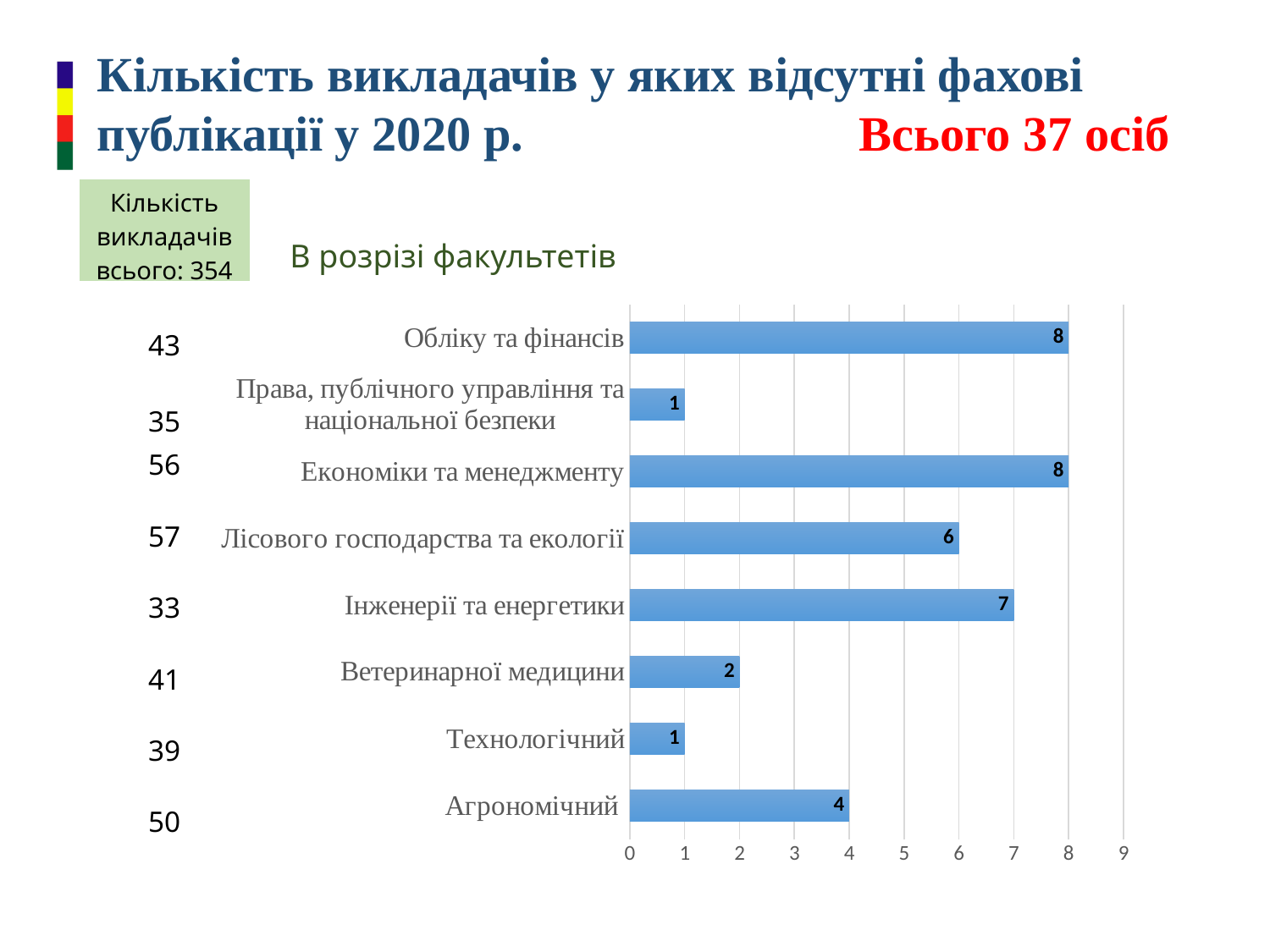
Which has a larger value, Лісового господарства та екології or Ветеринарної медицини? Лісового господарства та екології What is the difference between the values for Інженерії та енергетики and Агрономічний? 3 Is the value for Економіки та менеджменту greater or less than 5? greater What is the value for Агрономічний? 4 What is the highest value shown in the chart? 8 What is the value for Інженерії та енергетики? 7 What is the value for Обліку та фінансів? 8 According to the slide title, what is the total number of people (Всього)? 37 осіб How many faculties (categories) are shown in the chart? 8 What type of chart is shown on the slide? bar chart What is the value for Лісового господарства та екології? 6 What is the value for Ветеринарної медицини? 2